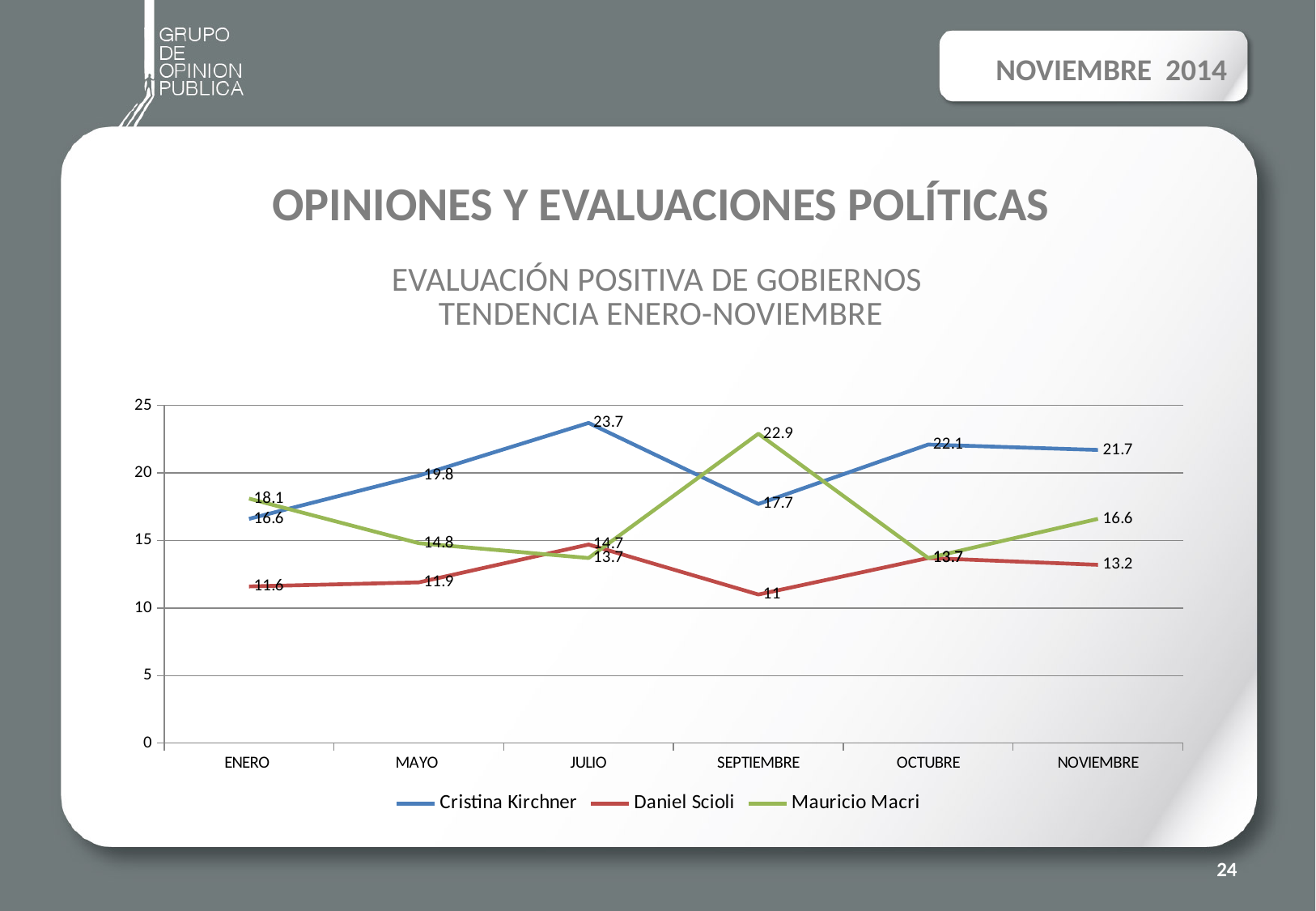
In which month does Daniel Scioli have his lowest value? SEPTIEMBRE What is the value for Daniel Scioli in SEPTIEMBRE? 11 In SEPTIEMBRE, who has the higher value, Mauricio Macri or Cristina Kirchner? Mauricio Macri Does Cristina Kirchner's line rise or fall from ENERO to JULIO? Rises How many months are shown on the x axis? 6 What is the value for Mauricio Macri in SEPTIEMBRE? 22.9 What is the value for Mauricio Macri in NOVIEMBRE? 16.6 What is the difference between Cristina Kirchner's value in JULIO and in SEPTIEMBRE? 6 How many series does the legend list? 3 In which month does Cristina Kirchner reach her highest value? JULIO What kind of chart is shown on the slide? Line chart What is the value for Cristina Kirchner in JULIO? 23.7